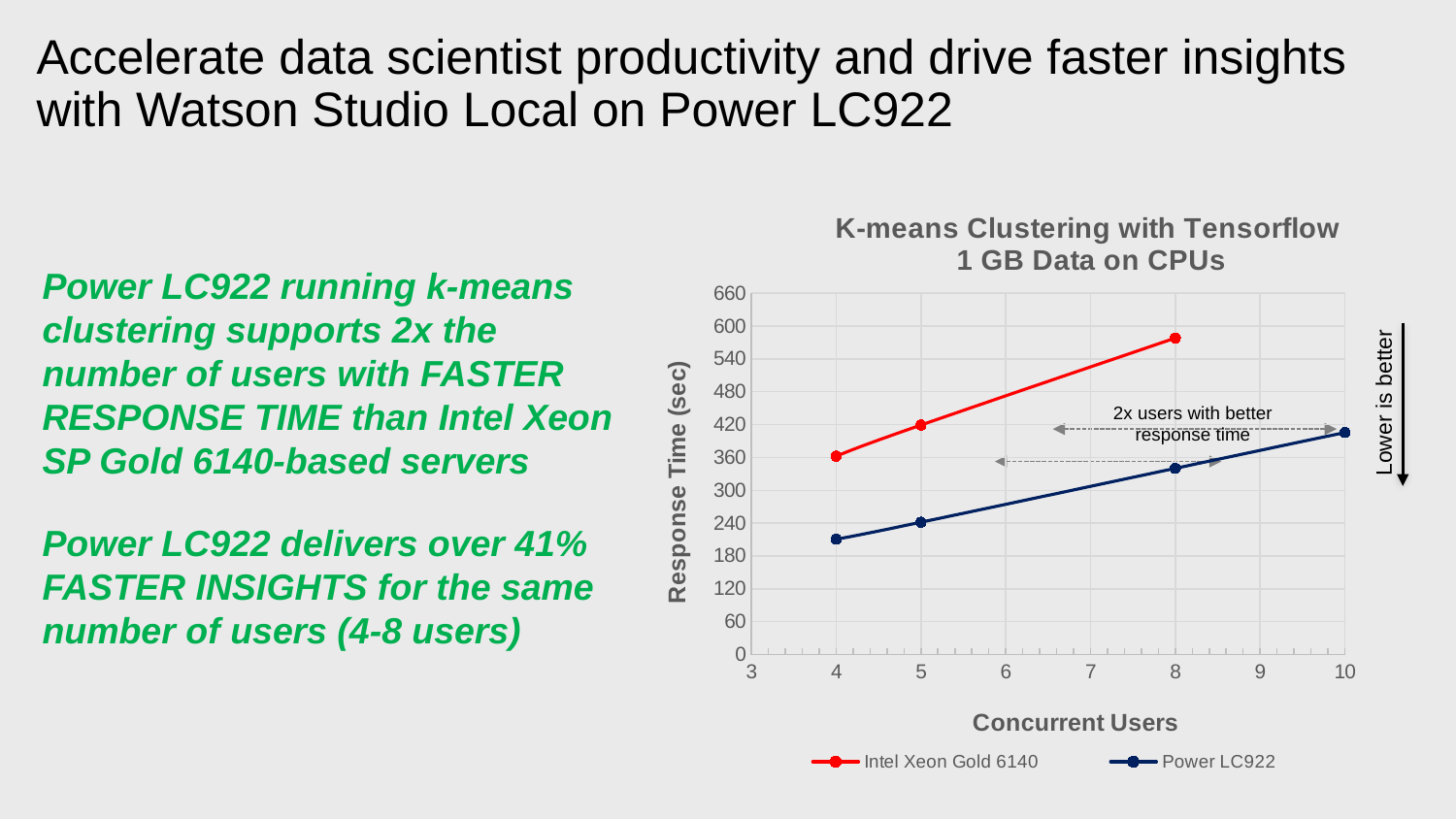
Does the response time for Power LC922 rise or fall as the number of concurrent users increases? rise Is the response time for Power LC922 at 10 concurrent users greater or less than 360? greater What is the label of the y axis of the chart? Response Time (sec) How many series does the chart legend list? 2 What is the title of the chart? K-means Clustering with Tensorflow 1 GB Data on CPUs How many data points are plotted for the Power LC922 series? 4 How many data points are plotted for the Intel Xeon Gold 6140 series? 3 What kind of chart is shown on the slide? line chart Is the response time for Power LC922 at 4 concurrent users greater or less than 240? less At 8 concurrent users, which series has the higher response time, Intel Xeon Gold 6140 or Power LC922? Intel Xeon Gold 6140 Does the response time for Intel Xeon Gold 6140 rise or fall as the number of concurrent users increases? rise Is the response time for Intel Xeon Gold 6140 at 8 concurrent users greater or less than 540? greater